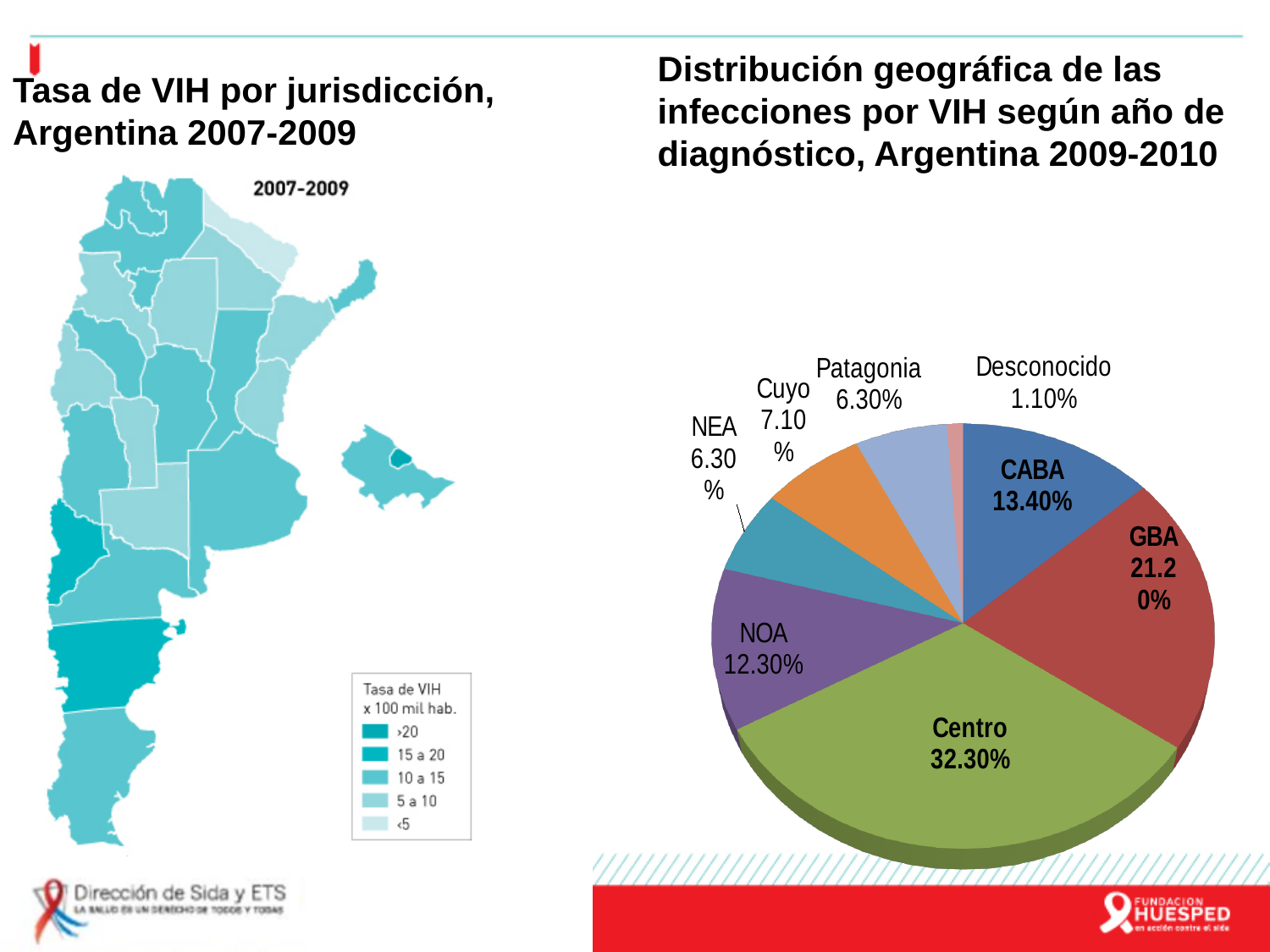
In the pie chart on the right, what is the difference between the Centro and GBA percentages? 11.10% In the pie chart on the right, how many slices does the pie have? 8 In the pie chart on the right, which category has the smallest slice? Desconocido In the pie chart on the right, what percentage is shown for CABA? 13.40% In the pie chart on the right, what value is labelled for Desconocido? 1.10% In the pie chart on the right, what is the value shown for Cuyo? 7.10% In the pie chart on the right, what is the value shown for GBA? 21.20% In the pie chart on the right, which two regions share the same value of 6.30%? NEA and Patagonia In the pie chart 'Distribución geográfica de las infecciones por VIH según año de diagnóstico, Argentina 2009-2010', what share is labelled for Centro? 32.30% In the pie chart on the right, which region has the largest slice? Centro What kind of chart is shown on the right side of the slide? Pie chart In the pie chart on the right, which is larger, the share for CABA or the share for NOA? CABA